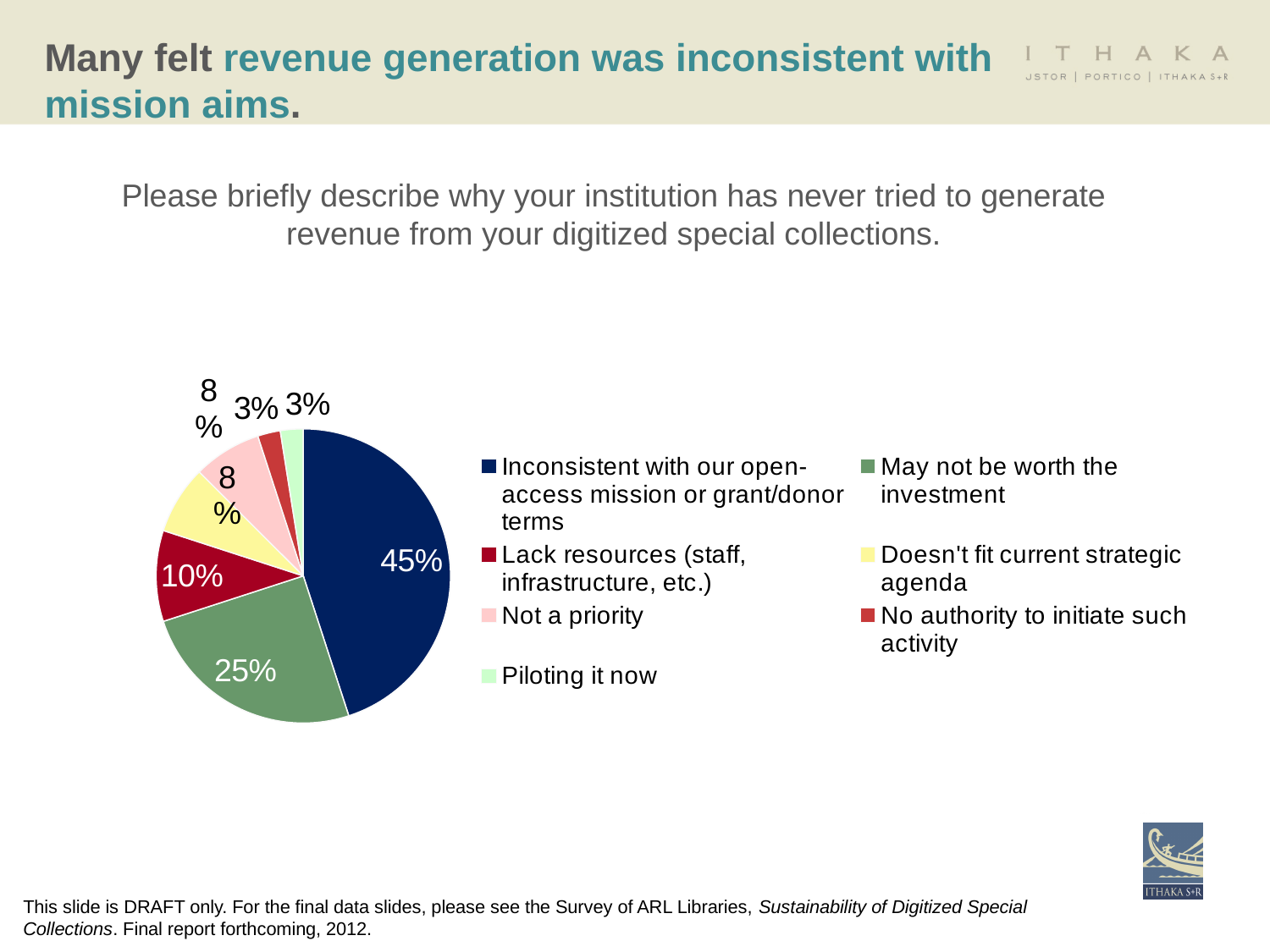
What type of chart is shown on the slide? Pie chart What colour is the slice representing 'May not be worth the investment'? Green Which is larger: the share for 'Lack resources (staff, infrastructure, etc.)' or the share for 'Not a priority'? Lack resources (staff, infrastructure, etc.) What percentage of respondents said it doesn't fit the current strategic agenda? 8% What percentage of respondents cited a lack of resources (staff, infrastructure, etc.)? 10% What percentage of respondents said revenue generation was inconsistent with their open-access mission or grant/donor terms? 45% What is the difference in percentage points between 'Inconsistent with our open-access mission or grant/donor terms' and 'May not be worth the investment'? 20 Which reason accounts for the largest share of the pie? Inconsistent with our open-access mission or grant/donor terms What is the combined share of 'Not a priority' and 'Doesn't fit current strategic agenda'? 16% How many categories are shown in the pie chart? 7 What percentage of respondents said it may not be worth the investment? 25% What percentage of respondents said they are piloting it now? 3%